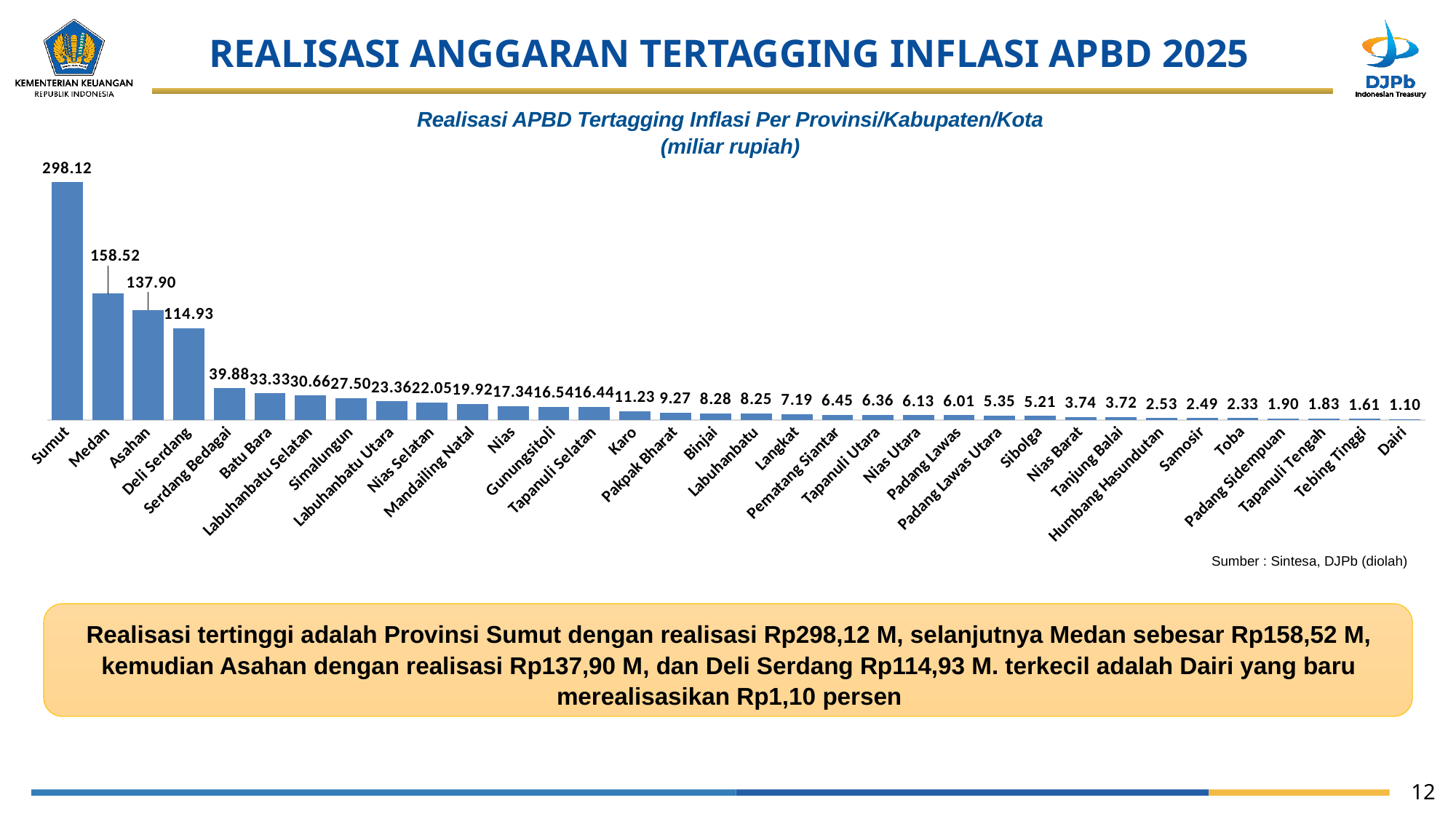
What is the value for Langkat? 7.19 What is the difference between the values for Sumut and Medan? 139.60 What is the value for Deli Serdang? 114.93 What kind of chart is shown on the slide? Bar chart What is the value for Sumut? 298.12 Which is larger, the value for Karo or the value for Binjai? Karo Which category has the highest value? Sumut Which category has the lowest value? Dairi Do the values rise or fall from left to right along the x axis? Fall What is the difference between the values for Medan and Asahan? 20.62 What is the value for Simalungun? 27.50 How many categories are shown on the x axis? 34